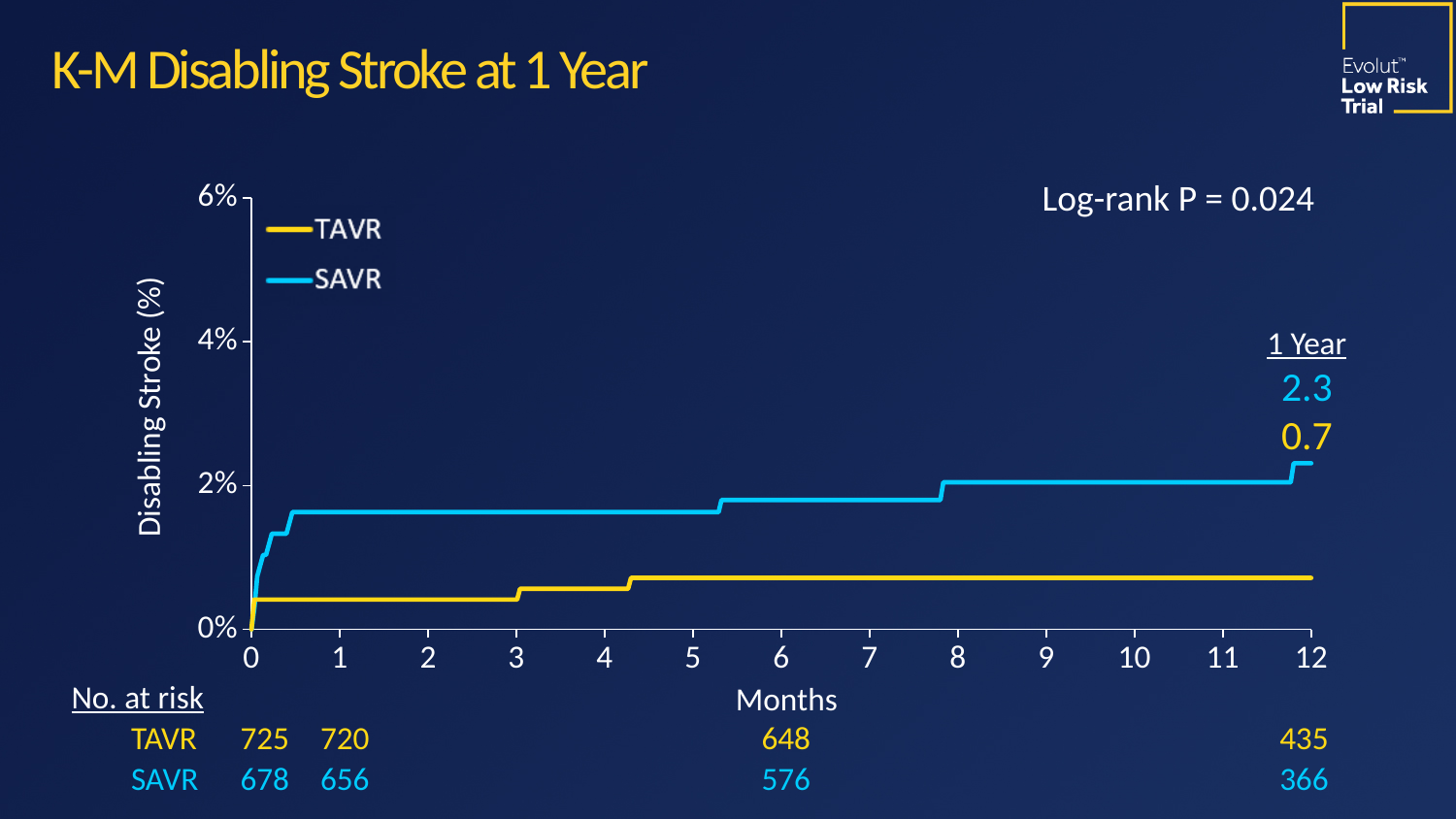
What is the 1-year disabling stroke rate for TAVR? 0.7 What is the difference between the SAVR and TAVR disabling stroke rates at 1 year? 1.6 What is the label of the y axis? Disabling Stroke (%) What is the log-rank P value shown on the chart? 0.024 Is the SAVR curve at 12 months greater or less than 2%? greater What is the 1-year disabling stroke rate for SAVR? 2.3 What is the number at risk for TAVR at 12 months? 435 Is the TAVR curve at 12 months greater or less than 2%? less What is the number at risk for SAVR at month 0? 678 Do the disabling stroke curves rise or fall over the months shown? rise How many series does the legend list? 2 Which group has the higher disabling stroke rate at 1 year, TAVR or SAVR? SAVR